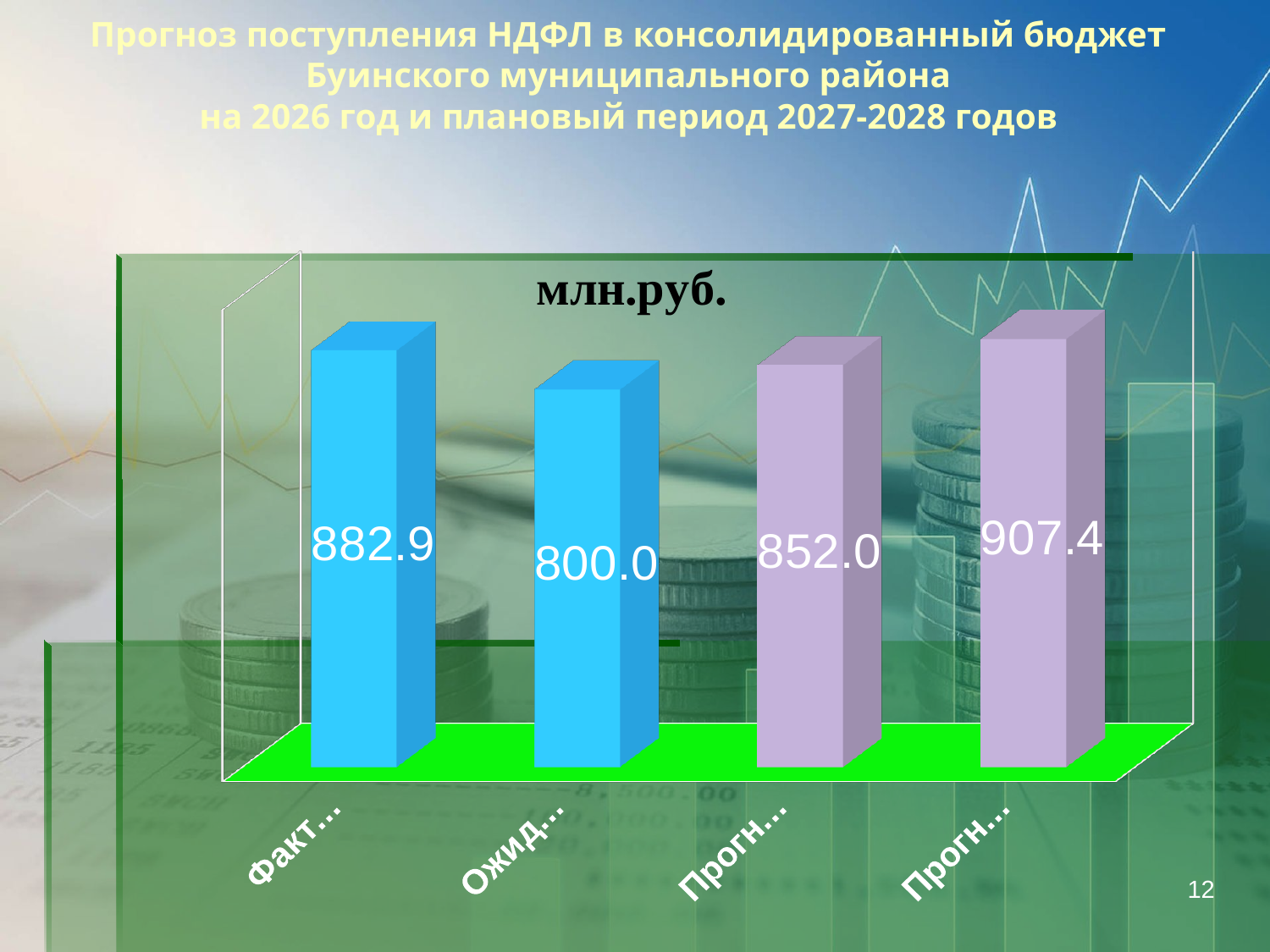
Which bar has the lowest value in the chart? The second bar, 800.0 What value is shown on the second bar of the chart? 800.0 What value is shown on the fourth (rightmost) bar of the chart? 907.4 What is the difference between the fourth bar (907.4) and the first bar (882.9)? 24.5 How many bars are plotted in the chart? 4 What value is shown on the first (leftmost) bar of the chart? 882.9 Which bar has the highest value in the chart? The fourth (rightmost) bar, 907.4 Which is larger: the value of the first bar or the value of the third bar? The first bar (882.9) What kind of chart is shown on the slide? Bar chart What is the difference between the fourth bar (907.4) and the third bar (852.0)? 55.4 What is the difference between the first bar (882.9) and the second bar (800.0)? 82.9 What value is shown on the third bar of the chart? 852.0